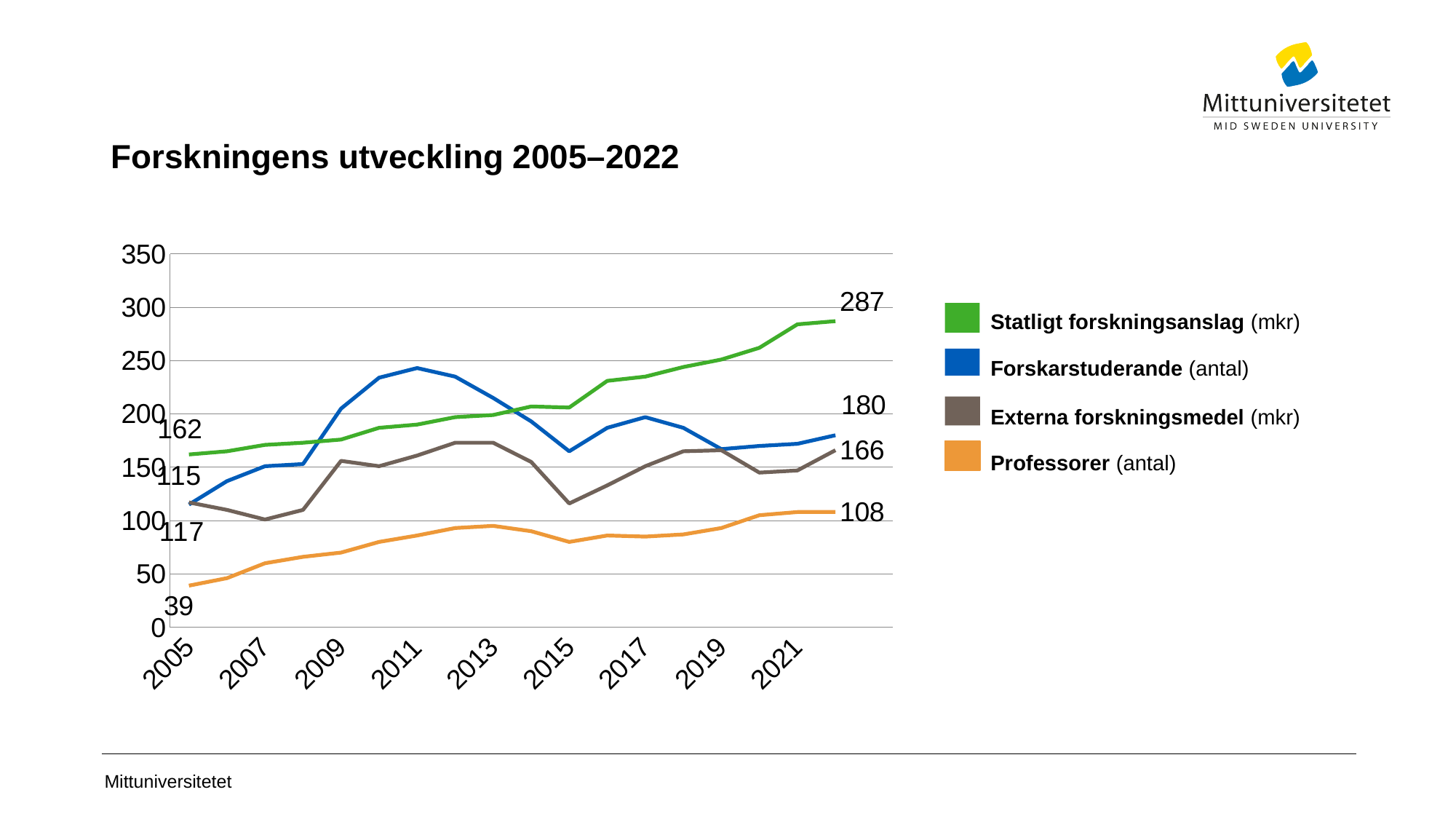
How many series does the legend list? 4 What is the value of Professorer (antal) in 2022? 108 What is the value of Statligt forskningsanslag (mkr) in 2022? 287 What is the value of Forskarstuderande (antal) in 2022? 180 Is the value for Forskarstuderande in 2011 greater or less than 200? greater By how much did Statligt forskningsanslag (mkr) increase from 2005 to 2022? 125 What kind of chart is shown on the slide? line chart What is the value of Professorer (antal) in 2005? 39 What is the value of Statligt forskningsanslag (mkr) in 2005? 162 Which series has the highest value in 2022? Statligt forskningsanslag What is the title of the chart? Forskningens utveckling 2005–2022 What is the value of Externa forskningsmedel (mkr) in 2022? 166